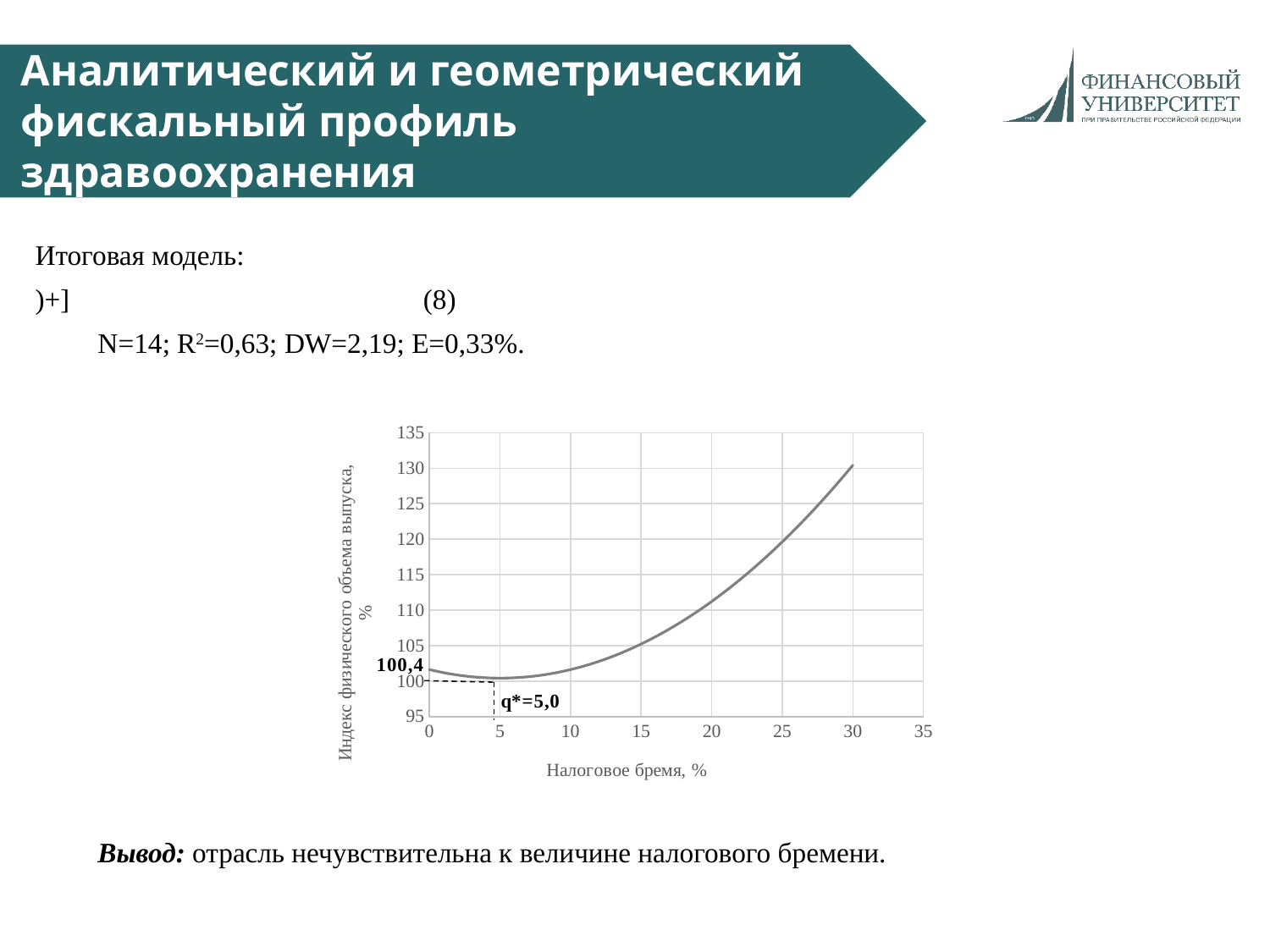
Is the value of the curve at a tax burden of 10 greater or less than 105? less Which is larger: the value of the curve at a tax burden of 30 or at a tax burden of 5? at 30 What is the lowest value of the curve, as labelled on the chart? 100,4 How many lines are plotted on the chart? 1 Does the curve rise or fall as the tax burden increases from 0 to 5? falls At what tax burden (q*) does the curve reach its minimum, according to the label on the chart? q*=5,0 Is the value of the curve at a tax burden of 20 greater or less than 115? less What is the title of the y axis of the chart? Индекс физического объема выпуска, % Is the value of the curve at a tax burden of 30 greater or less than 125? greater What is the title of the x axis of the chart? Налоговое бремя, % Does the curve rise or fall as the tax burden increases from 5 to 30? rises What kind of chart is shown on the slide? line chart